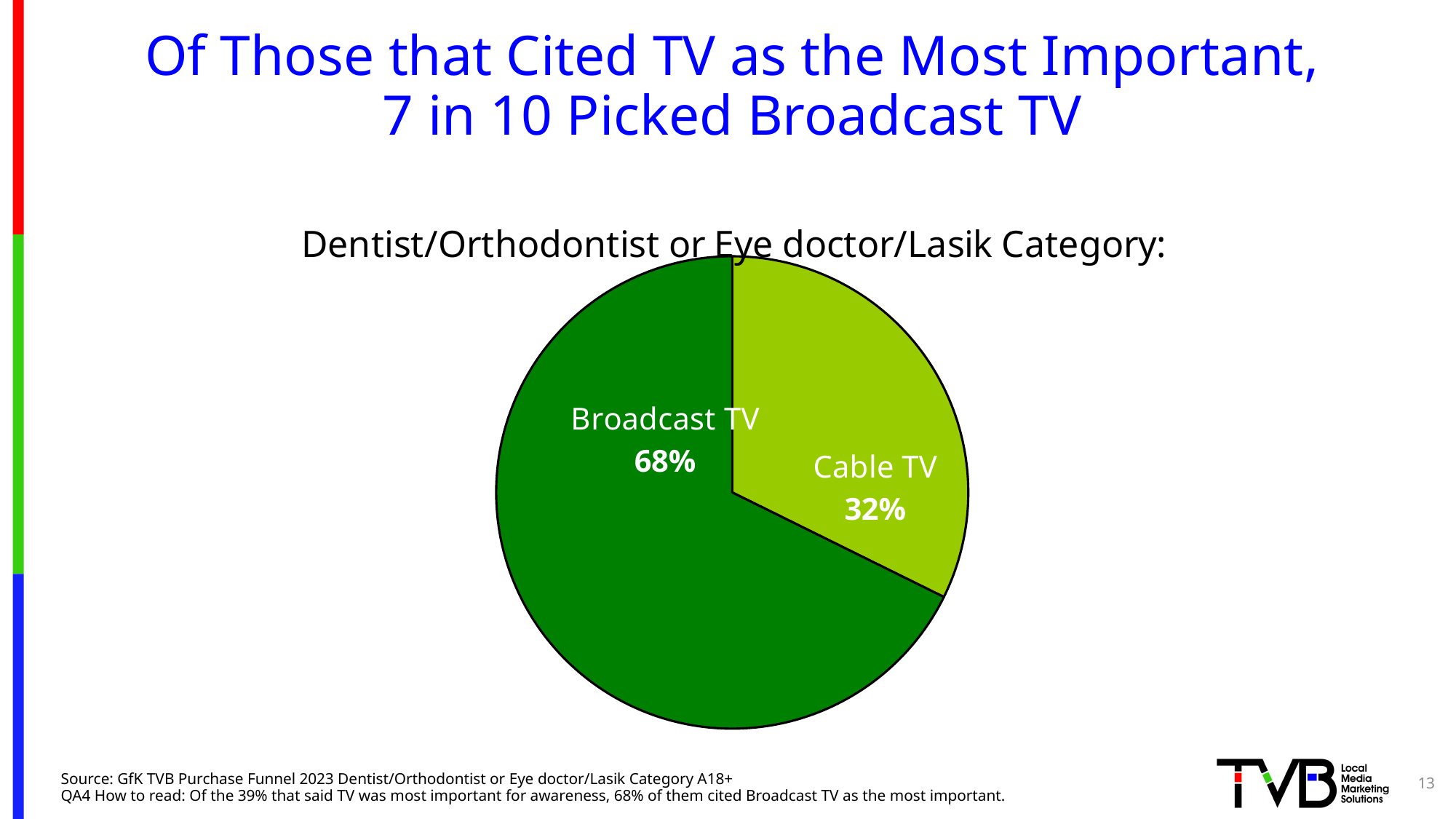
How many slices does the pie chart have? 2 Which slice of the pie is the largest? Broadcast TV What kind of chart is shown on the slide? Pie chart What share of the pie does Cable TV account for? 32% What share of the pie does Broadcast TV account for? 68% What is the title of the chart? Dentist/Orthodontist or Eye doctor/Lasik Category: Which is larger, the Broadcast TV slice or the Cable TV slice? Broadcast TV Which slice is shown in the lighter green colour? Cable TV What is the total of the two slices shown in the pie chart? 100% What is the difference in percentage points between the Broadcast TV and Cable TV slices? 36 Which slice of the pie is the smallest? Cable TV